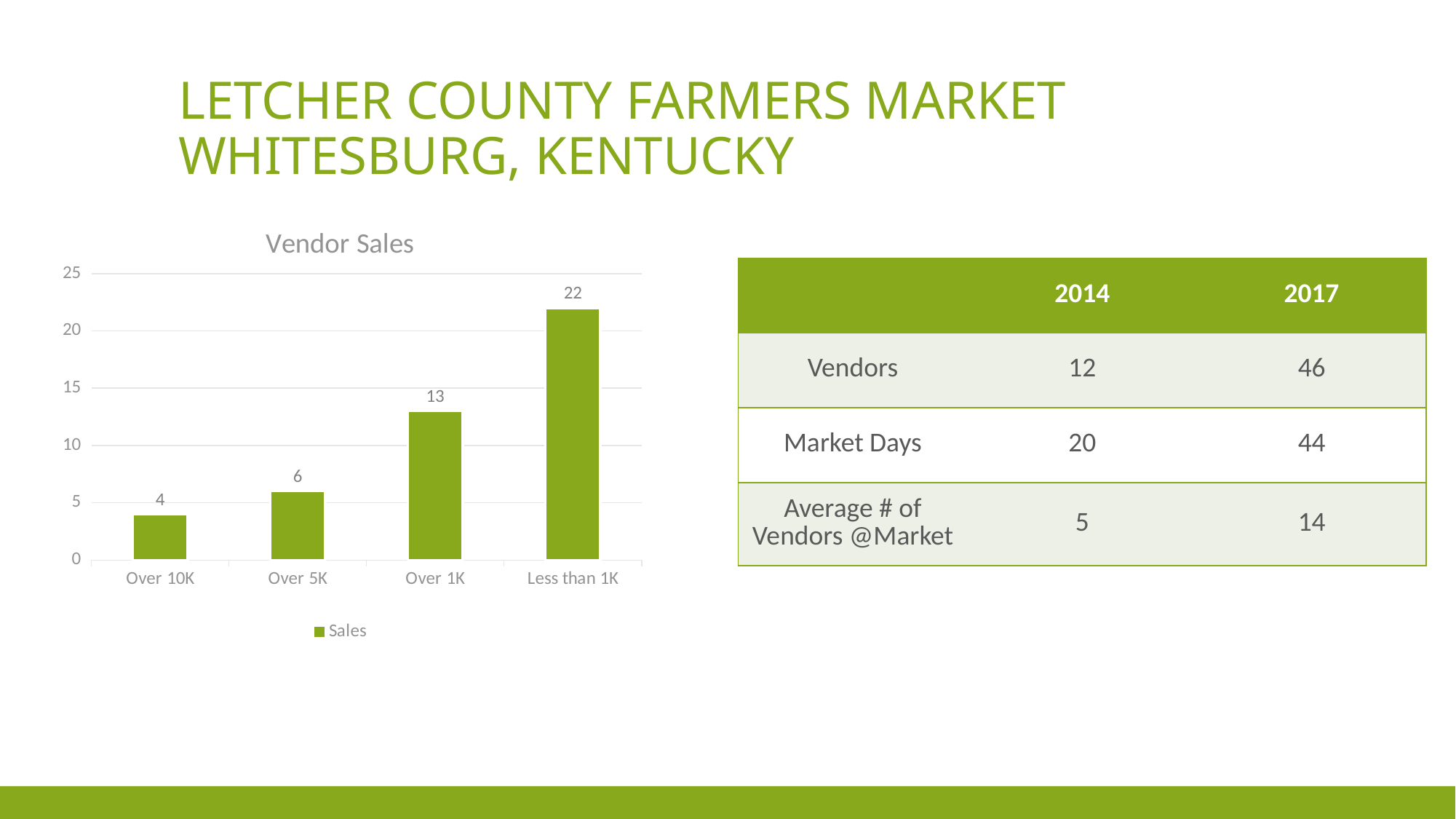
Which is larger in the Vendor Sales chart, Over 5K or Over 1K? Over 1K What is the value for Over 1K in the Vendor Sales chart? 13 What is the value for Over 5K in the Vendor Sales chart? 6 How many categories are shown in the Vendor Sales chart? 4 Which category has the lowest value in the Vendor Sales chart? Over 10K What is the value for Over 10K in the Vendor Sales chart? 4 Which category has the highest value in the Vendor Sales chart? Less than 1K What is the difference between the values for Less than 1K and Over 1K in the Vendor Sales chart? 9 What kind of chart is the Vendor Sales chart? bar chart What is the value for Less than 1K in the Vendor Sales chart? 22 Do the values in the Vendor Sales chart rise or fall from left to right along the x axis? rise How many series does the legend of the Vendor Sales chart list? 1